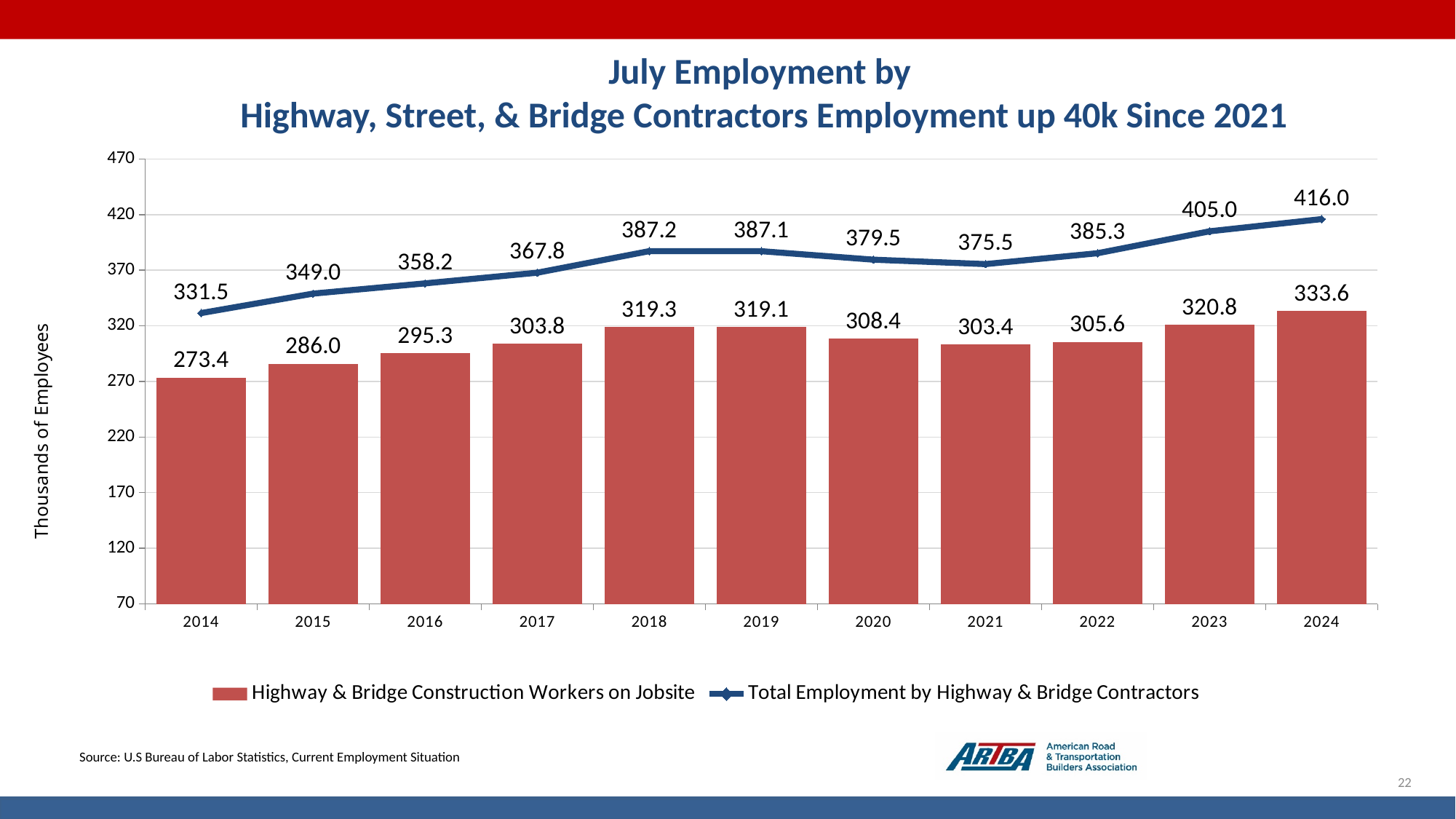
Which year has the highest value for Highway & Bridge Construction Workers on Jobsite? 2024 What kind of chart is this? Combined bar and line chart Which year has the lowest value for Total Employment by Highway & Bridge Contractors? 2014 What is the value for Highway & Bridge Construction Workers on Jobsite in 2014? 273.4 What is the difference between Total Employment by Highway & Bridge Contractors in 2024 and in 2021? 40.5 How many series does the legend list? 2 How many years are shown on the x axis? 11 Is the value for Highway & Bridge Construction Workers on Jobsite in 2016 greater or less than 320? less What is the value for Total Employment by Highway & Bridge Contractors in 2024? 416.0 What is the value for Total Employment by Highway & Bridge Contractors in 2021? 375.5 What is the y-axis label of the chart? Thousands of Employees Which is larger: Highway & Bridge Construction Workers on Jobsite in 2018 or in 2020? 2018